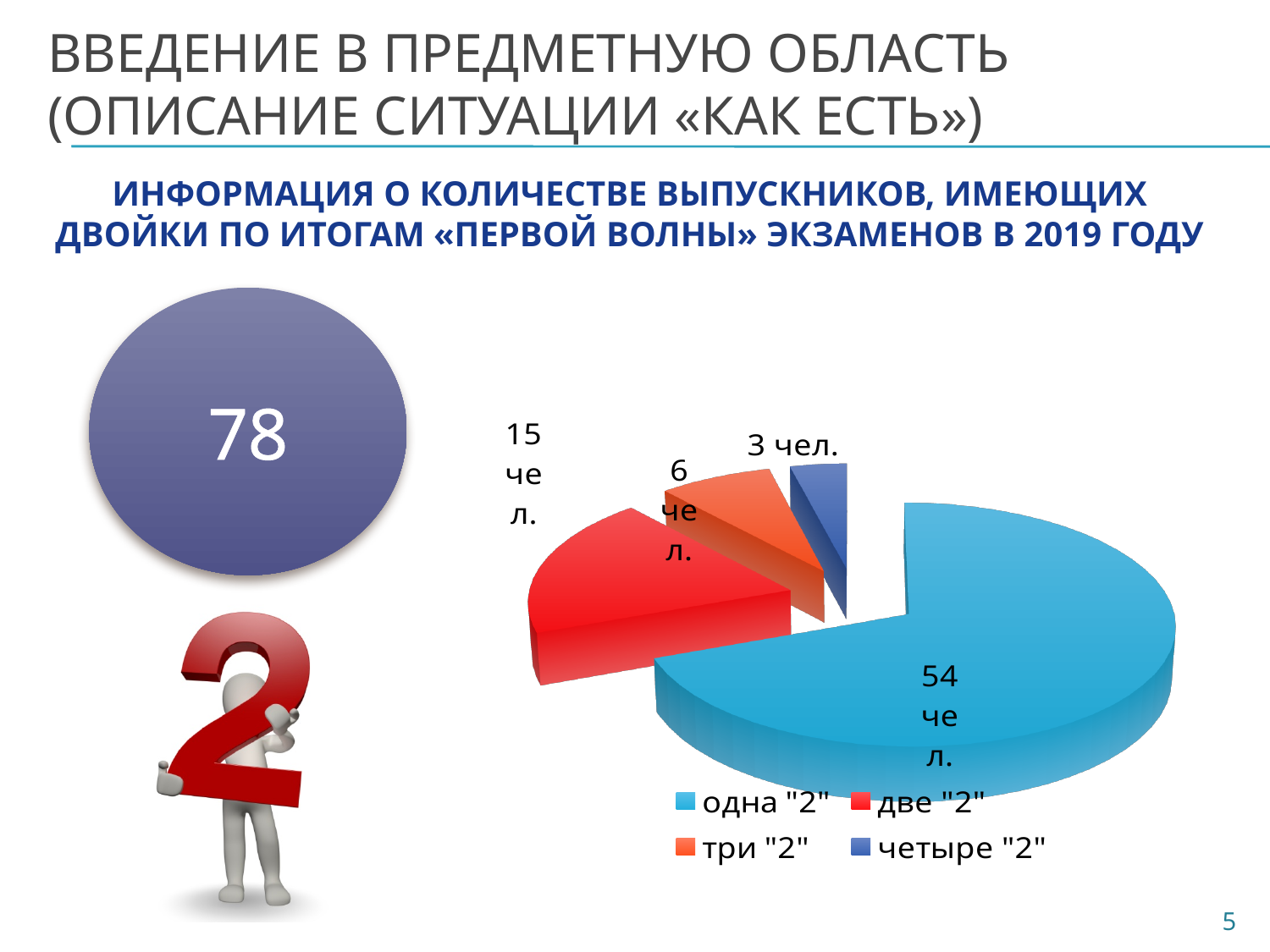
Which is larger in the pie chart: the value for три "2" or the value for четыре "2"? три "2" What is the value for the slice одна "2" in the pie chart? 54 чел. What is the value for the slice две "2" in the pie chart? 15 чел. What colour is the slice for две "2" in the pie chart? red What is the value for the slice три "2" in the pie chart? 6 чел. How many slices does the pie chart have? 4 What is the value for the slice четыре "2" in the pie chart? 3 чел. Which category has the smallest slice in the pie chart? четыре "2" How many entries does the legend of the pie chart list? 4 What is the difference between the values for одна "2" and две "2" in the pie chart? 39 чел. Which category has the largest slice in the pie chart? одна "2" What kind of chart is shown on the slide? pie chart